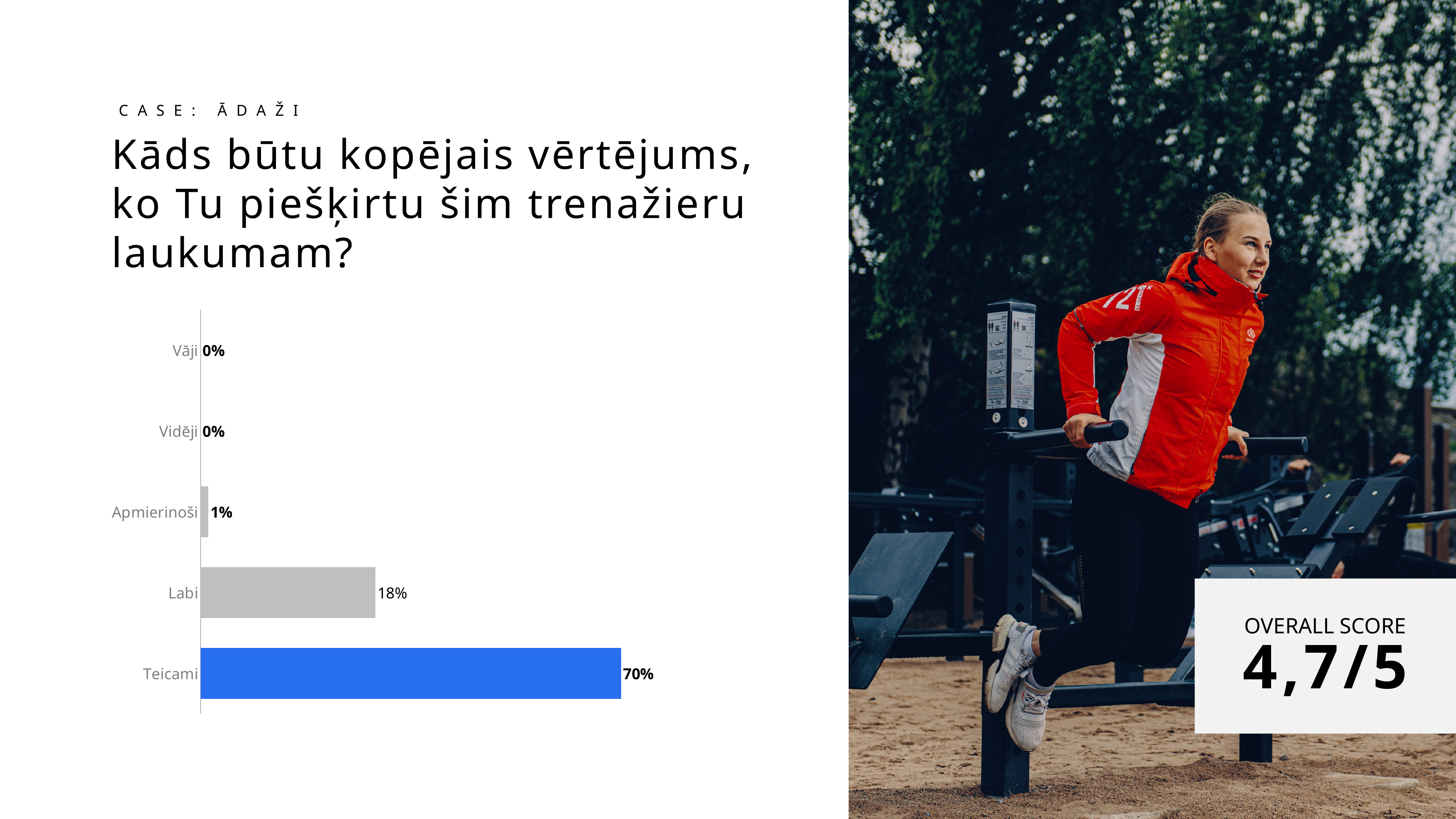
What is the difference between the values for Teicami and Labi? 52% What kind of chart is shown on the slide? Bar chart What is the value for Apmierinoši? 1% What is the difference between the values for Labi and Apmierinoši? 17% What is the value for Vāji? 0% What overall score is shown on the slide? 4,7/5 What is the value for Teicami? 70% What colour is the bar for Teicami? Blue Which category has the highest value? Teicami Which is larger, the value for Labi or the value for Apmierinoši? Labi How many categories are shown in the chart? 5 What is the value for Labi? 18%